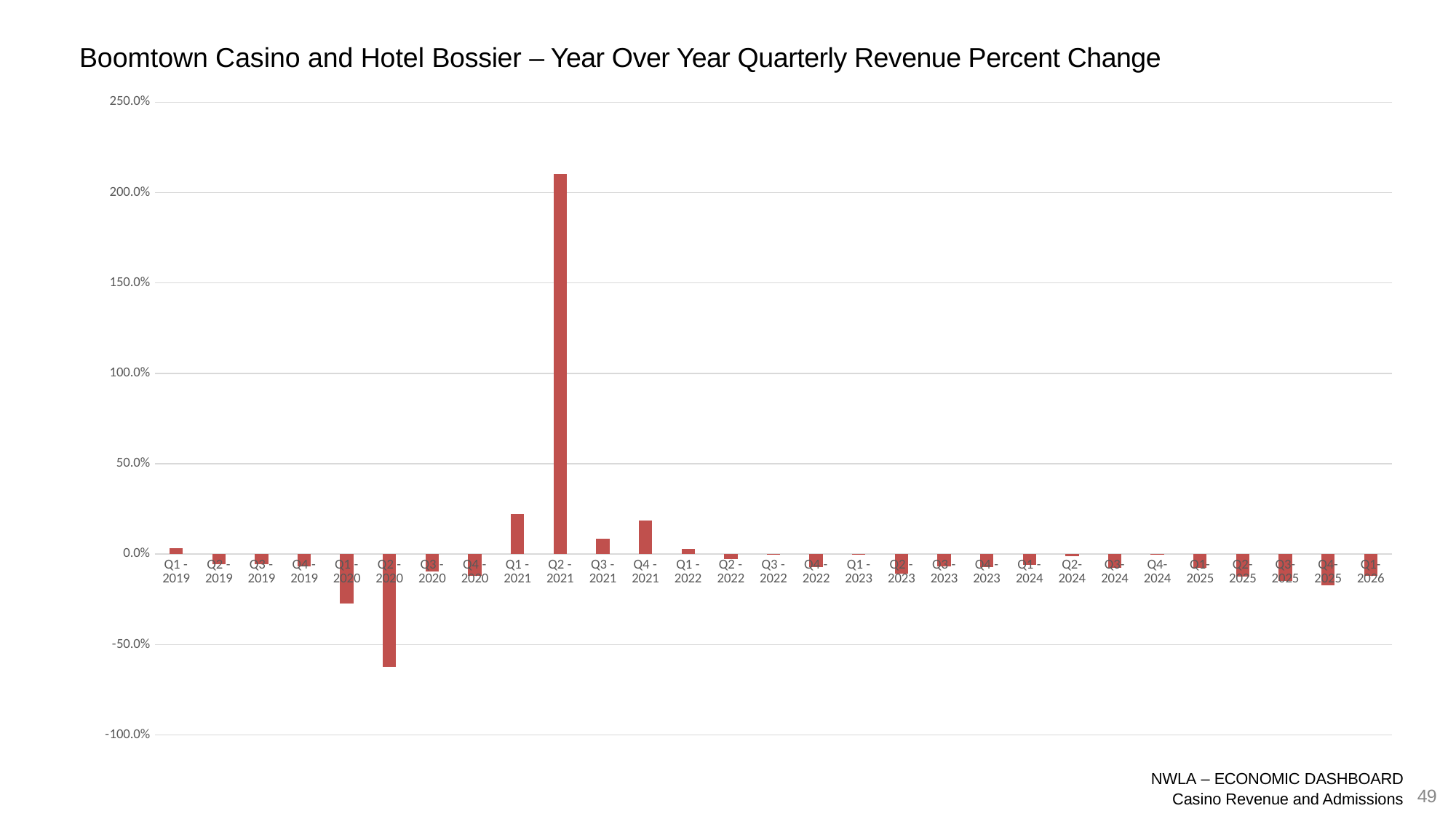
Which quarter has the lowest year-over-year revenue percent change? Q2 - 2020 Which quarter has the highest year-over-year revenue percent change? Q2 - 2021 Which is larger, the value for Q1 - 2020 or the value for Q2 - 2020? Q1 - 2020 What is the title of the chart? Boomtown Casino and Hotel Bossier – Year Over Year Quarterly Revenue Percent Change How many quarters are plotted on the x axis? 29 Which is larger, the value for Q1 - 2021 or the value for Q3 - 2021? Q1 - 2021 Is the value for Q1 - 2021 greater or less than 50.0%? less Is the value for Q1 - 2020 greater or less than -50.0%? greater What kind of chart is shown on the slide? bar chart Is the value for Q2 - 2021 greater or less than 200.0%? greater What colour are the bars in the chart? red